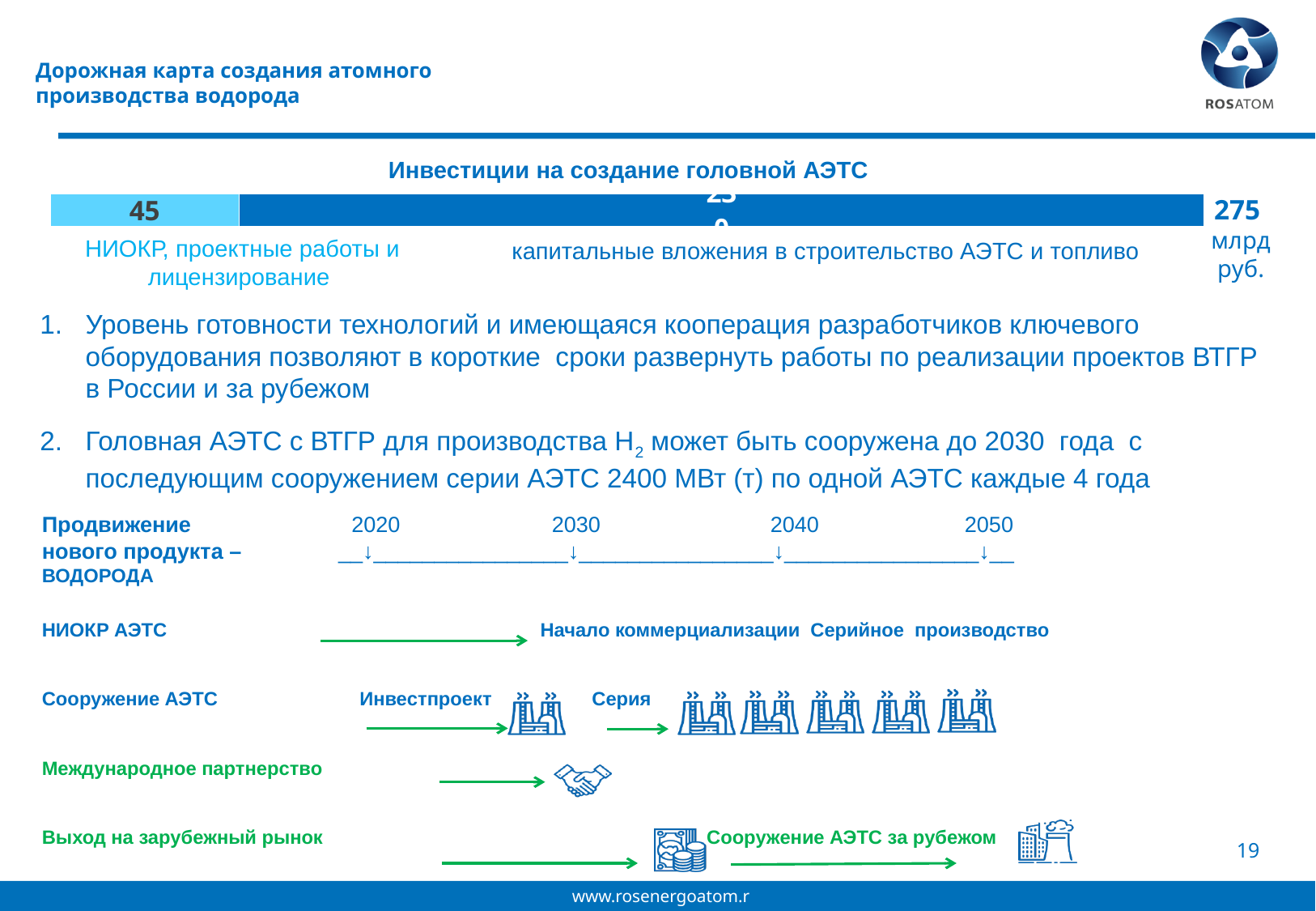
How many segments make up the stacked investment bar? 2 What is the title of the bar chart on the slide? Инвестиции на создание головной АЭТС Which segment of the investment bar has the largest value? капитальные вложения в строительство АЭТС и топливо What is the difference between the 'капитальные вложения' segment and the 'НИОКР' segment of the investment bar? 185 What kind of chart is used to show the investments for creating the lead АЭТС? bar chart What is the total of the stacked investment bar, as printed at its right end? 275 What is the value of the segment labelled 'капитальные вложения в строительство АЭТС и топливо' in the investment bar? 230 Which segment of the investment bar is larger: 'НИОКР, проектные работы и лицензирование' or 'капитальные вложения в строительство АЭТС и топливо'? капитальные вложения в строительство АЭТС и топливо In what units are the values of the investment bar expressed? млрд руб. Which segment of the investment bar has the smallest value? НИОКР, проектные работы и лицензирование What is the value of the segment labelled 'НИОКР, проектные работы и лицензирование' in the investment bar? 45